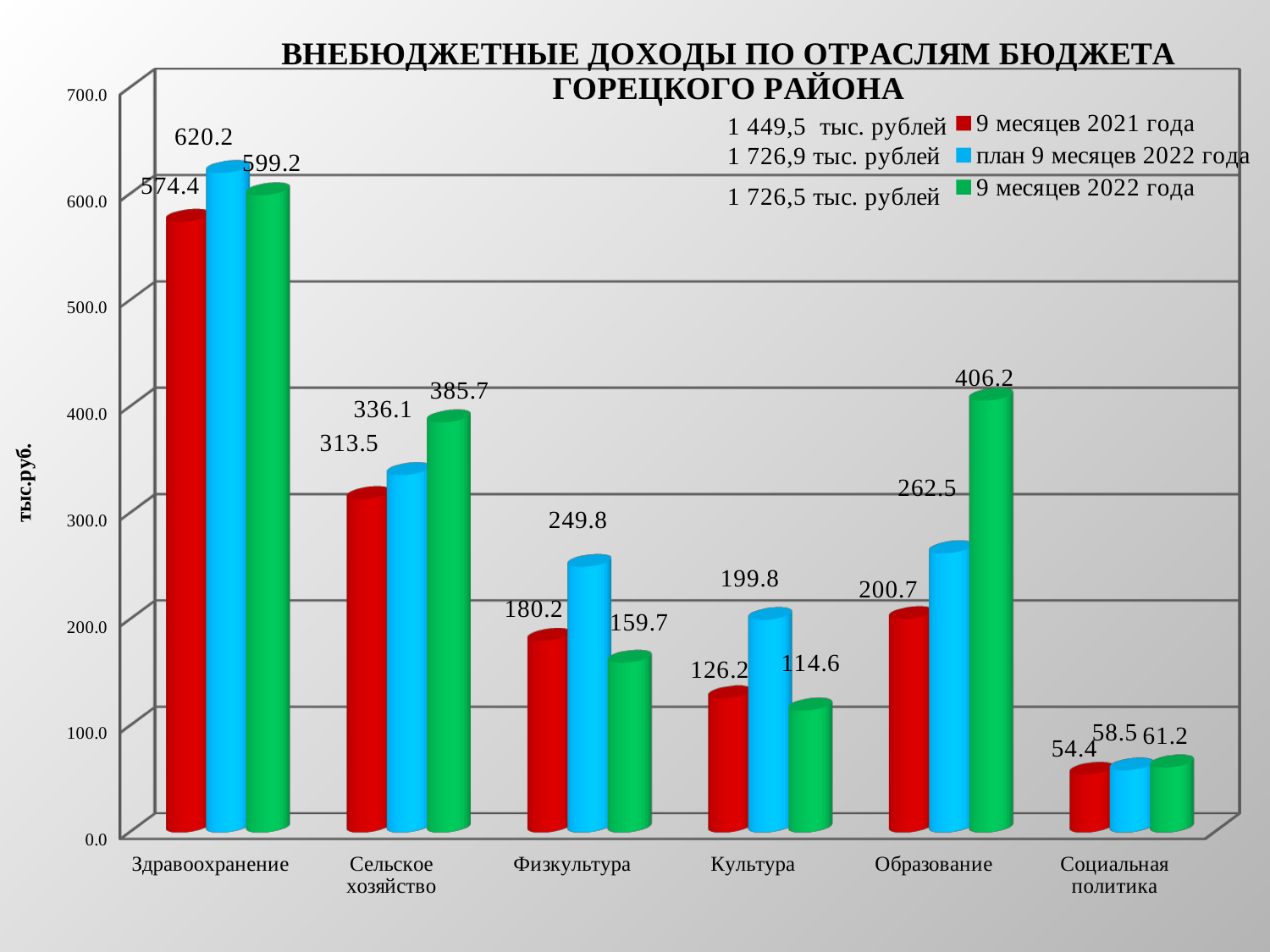
What is the label of the vertical axis? тыс.руб. What type of chart is shown on the slide? bar chart For Физкультура, which is larger: the value for 'план 9 месяцев 2022 года' or for '9 месяцев 2022 года'? план 9 месяцев 2022 года What is the value for Здравоохранение in the series 'план 9 месяцев 2022 года'? 620.2 Is the value for Сельское хозяйство in the series '9 месяцев 2022 года' greater or less than 300.0? greater What is the value for Образование in the series '9 месяцев 2022 года'? 406.2 How many series does the legend list? 3 What is the difference between the '9 месяцев 2022 года' and '9 месяцев 2021 года' values for Образование? 205.5 Which category has the lowest value in the series 'план 9 месяцев 2022 года'? Социальная политика How many categories are shown on the x axis? 6 What is the value for Культура in the series '9 месяцев 2021 года'? 126.2 Which category has the highest value in the series '9 месяцев 2022 года'? Здравоохранение